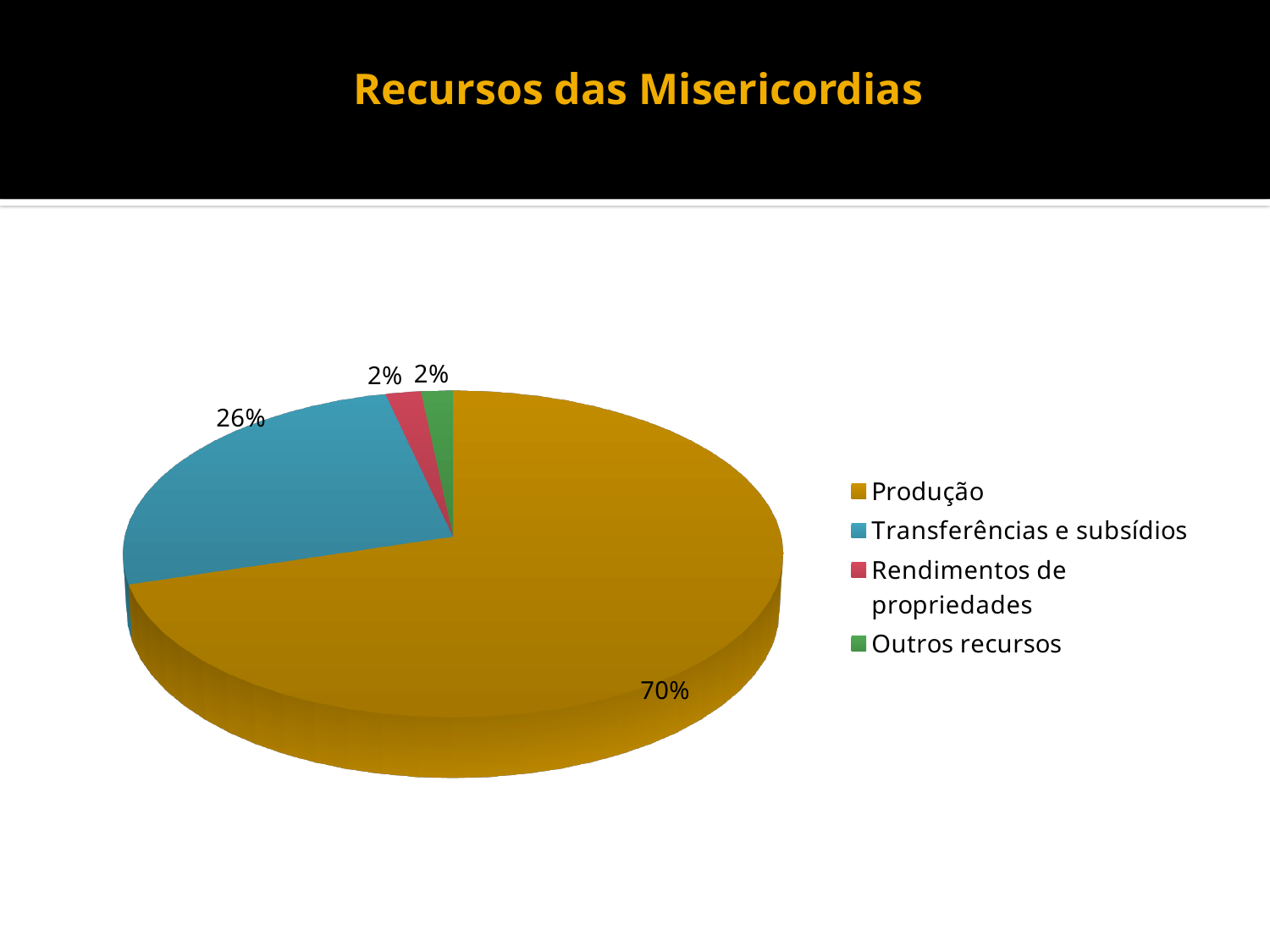
What kind of chart is shown on the slide? Pie chart What colour is the slice for Transferências e subsídios? Blue Which is larger, the slice for Transferências e subsídios or the slice for Outros recursos? Transferências e subsídios What is the title of the slide? Recursos das Misericordias Which category has the largest slice of the pie? Produção What share of the pie does Outros recursos account for? 2% What share of the pie does Rendimentos de propriedades account for? 2% What share of the pie does Produção account for? 70% What is the combined share of Rendimentos de propriedades and Outros recursos? 4% What is the difference in percentage points between Produção and Transferências e subsídios? 44 How many categories are shown in the pie chart? 4